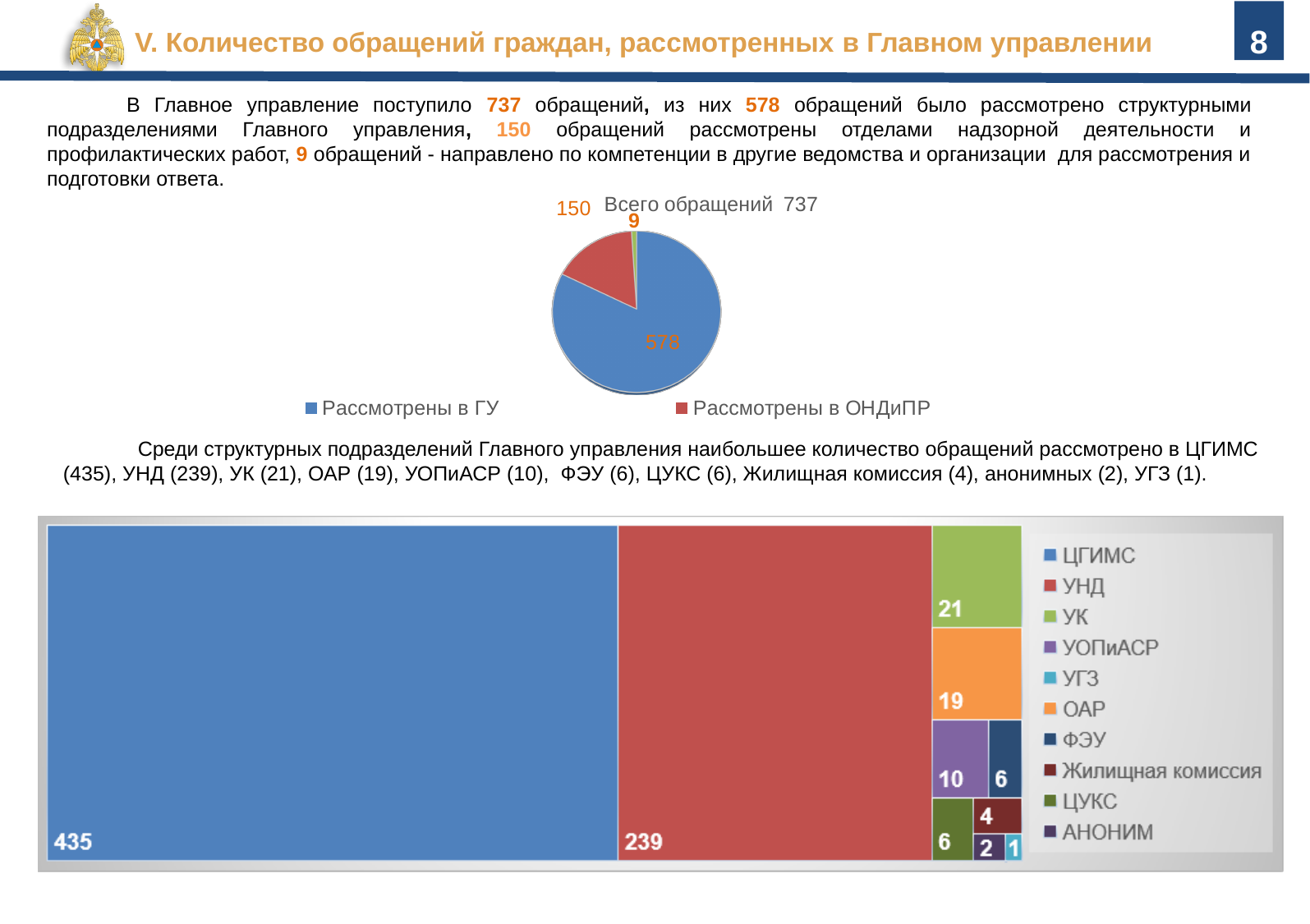
What kind of chart is the chart titled 'Всего обращений 737'? pie chart In the chart at the bottom of the slide, what is the difference between the values for ЦГИМС and УНД? 196 In the chart at the bottom of the slide, what is the value for ЦГИМС? 435 In the pie chart titled 'Всего обращений 737', which slice is the largest? Рассмотрены в ГУ In the chart at the bottom of the slide, what is the value for УНД? 239 In the chart at the bottom of the slide, which category has the lowest value? УГЗ In the pie chart titled 'Всего обращений 737', what is the value for 'Рассмотрены в ОНДиПР'? 150 In the chart at the bottom of the slide, which category has the highest value? ЦГИМС In the pie chart titled 'Всего обращений 737', what is the value for 'Рассмотрены в ГУ'? 578 In the chart at the bottom of the slide, what is the value for ОАР? 19 How many categories does the legend of the chart at the bottom of the slide list? 10 In the pie chart titled 'Всего обращений 737', what is the difference between the 'Рассмотрены в ГУ' slice and the 'Рассмотрены в ОНДиПР' slice? 428